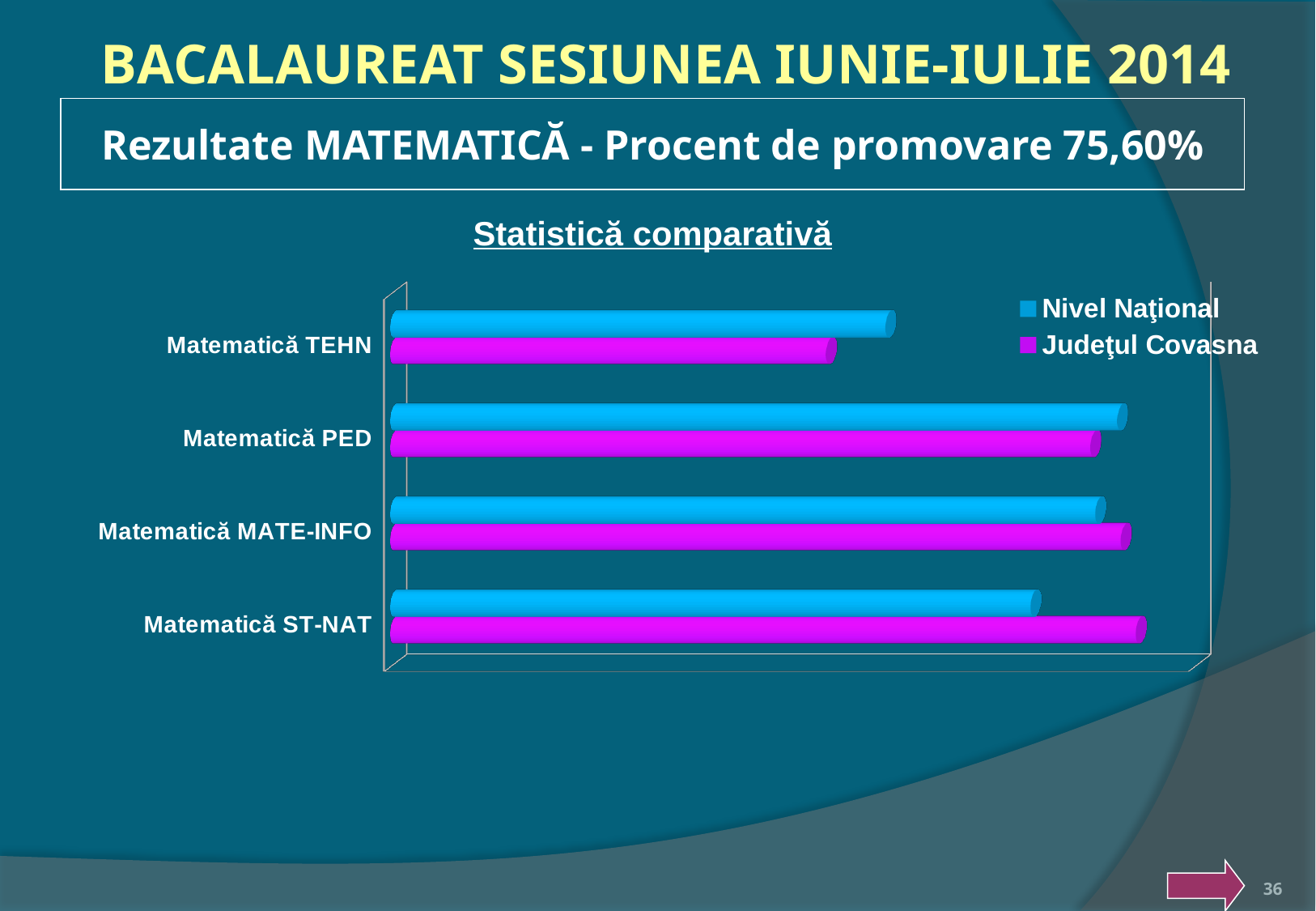
How many categories are shown on the chart? 4 Which category has the lowest value for Nivel Naţional? Matematică TEHN Is the Judeţul Covasna bar for Matematică TEHN longer or shorter than the Judeţul Covasna bar for Matematică PED? shorter For Matematică ST-NAT, which is larger: Nivel Naţional or Judeţul Covasna? Judeţul Covasna Which series is shown in magenta on the chart? Judeţul Covasna For Matematică TEHN, which is larger: Nivel Naţional or Judeţul Covasna? Nivel Naţional How many series does the chart legend list? 2 What kind of chart is shown on the slide? bar chart Which category has the lowest value for Judeţul Covasna? Matematică TEHN What is the title of the chart? Statistică comparativă